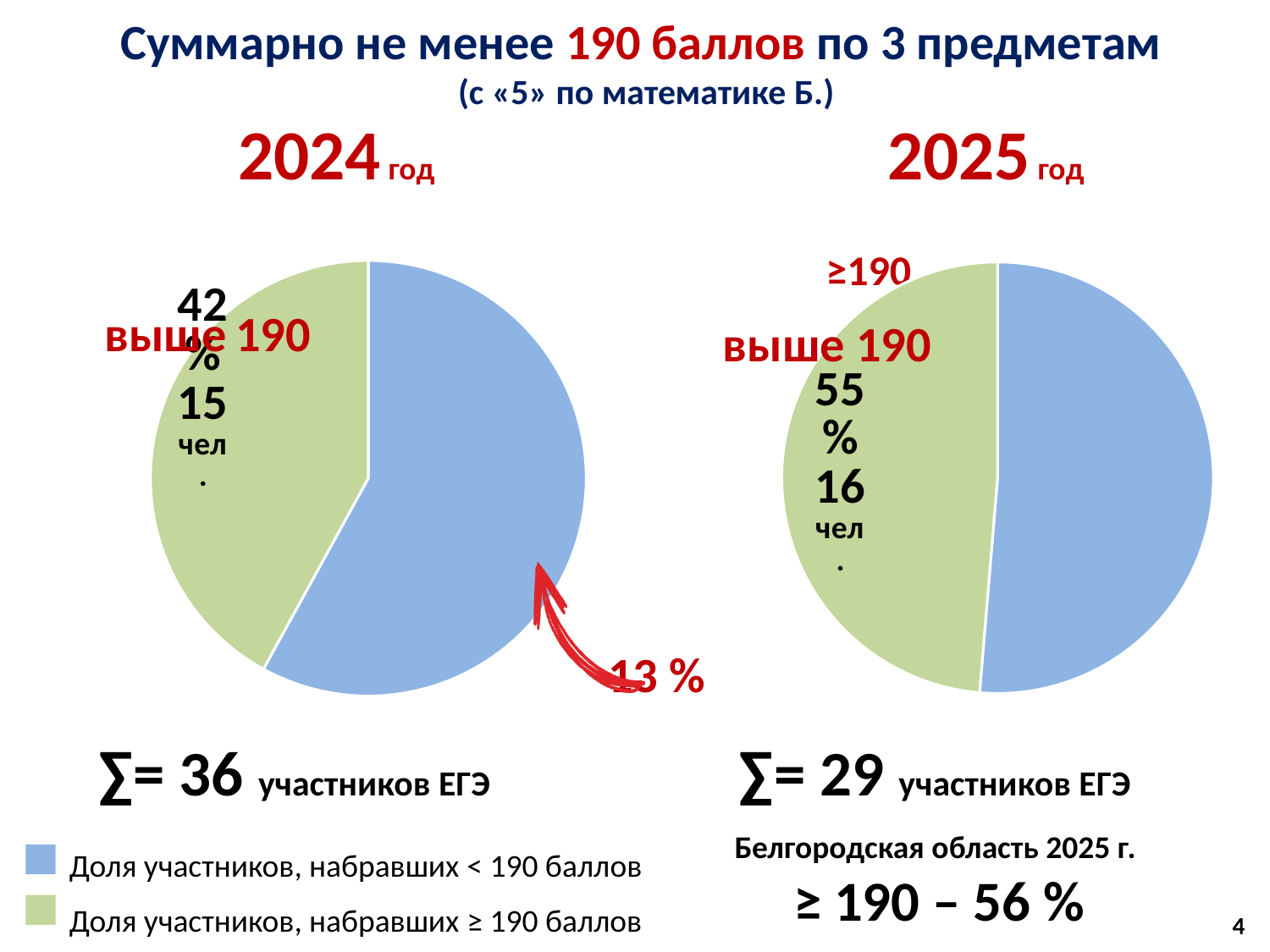
In the 2025 pie chart, how many people (чел.) scored ≥ 190 points? 16 чел. In the 2024 pie chart, how many people (чел.) scored ≥ 190 points? 15 чел. In the 2024 pie chart, which slice is larger: participants with < 190 points (blue) or ≥ 190 points (green)? < 190 points (blue) By how many percentage points did the share of participants scoring ≥ 190 change from the 2024 chart to the 2025 chart? 13 % In the 2024 pie chart, what share of participants scored ≥ 190 points? 42 % What type of chart is used on the slide for the 2024 and 2025 data? pie chart How many entries does the legend list for the pie charts? 2 What is the total number of ЕГЭ participants shown for the 2025 pie chart? 29 What is the total number of ЕГЭ participants shown for the 2024 pie chart? 36 In the 2025 pie chart, what share of participants scored ≥ 190 points? 55 % Which colour represents the share of participants who scored ≥ 190 points in the pie charts? green